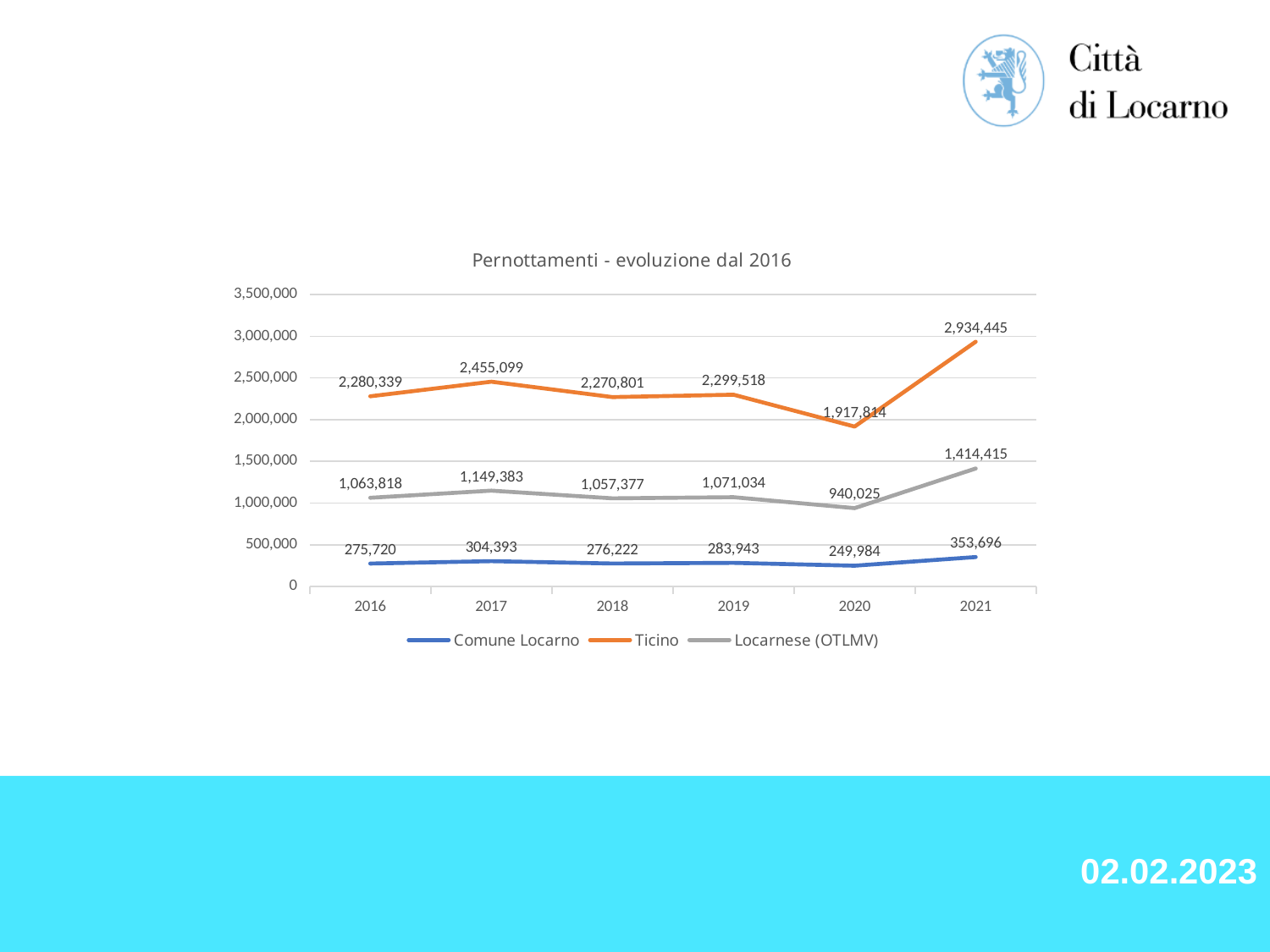
What is the value for Locarnese (OTLMV) in 2020? 940,025 What is the difference between the Ticino values for 2021 and 2020? 1,016,631 Which is larger, the Locarnese (OTLMV) value in 2017 or in 2019? 2017 What is the value for Comune Locarno in 2017? 304,393 What is the value for Ticino in 2021? 2,934,445 In which year is the value for Comune Locarno highest? 2021 How many years are shown on the x axis? 6 In which year is the value for Ticino lowest? 2020 Which series is shown in orange? Ticino What type of chart is shown on the slide? Line chart How many series does the legend list? 3 What is the title of the chart? Pernottamenti - evoluzione dal 2016